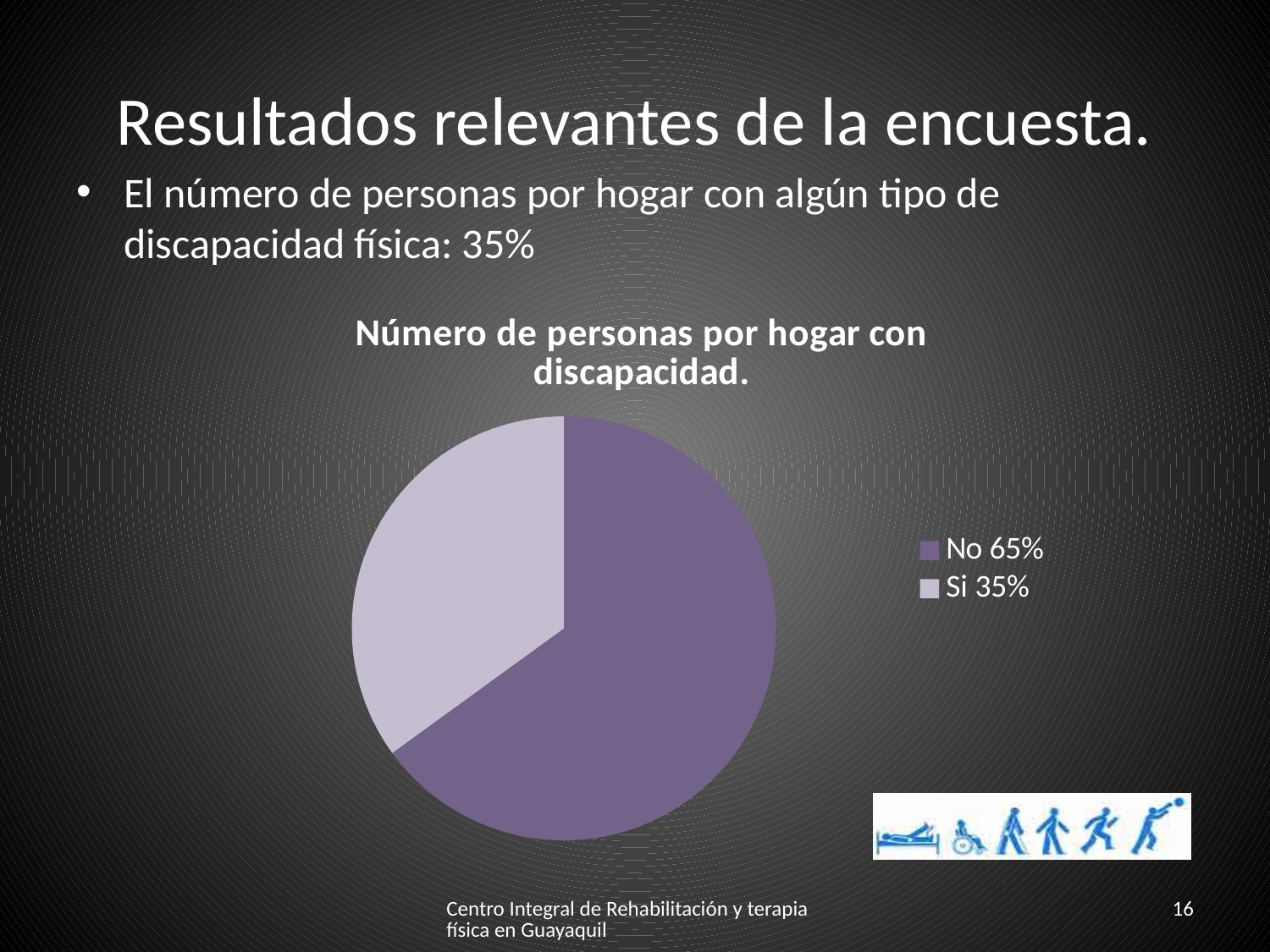
How many slices does the pie chart have? 2 What is the difference in percentage points between the "No" and "Si" slices? 30% Which legend entry is shown in the lighter purple colour? Si 35% What kind of chart is shown on the slide? pie chart What share of the pie does the "Si" slice represent? 35% How many entries does the legend list? 2 Which slice of the pie is the smallest? Si Which is larger, the "Si" slice or the "No" slice? No Is the share for "Si" greater or less than 50%? less Which slice of the pie is the largest? No What is the title of the chart? Número de personas por hogar con discapacidad. What share of the pie does the "No" slice represent? 65%